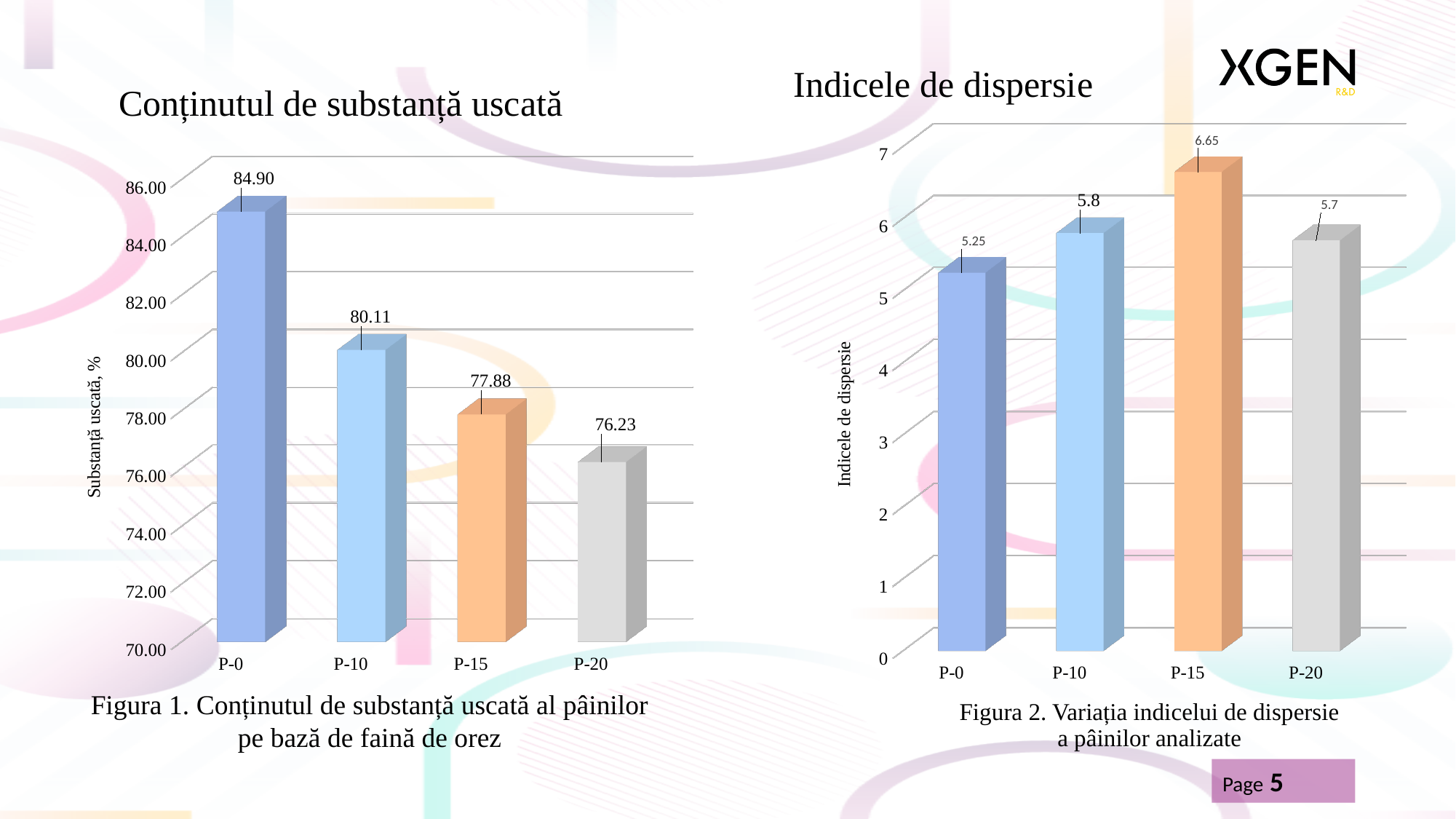
In the chart titled "Conținutul de substanță uscată", what is the value for P-15? 77.88 In the chart titled "Conținutul de substanță uscată", which category has the lowest value? P-20 What kind of chart is the chart titled "Indicele de dispersie"? bar chart In the chart titled "Indicele de dispersie", what is the value for P-15? 6.65 In the chart titled "Conținutul de substanță uscată", what is the value for P-0? 84.90 In the chart titled "Indicele de dispersie", which category has the highest value? P-15 In the chart titled "Conținutul de substanță uscată", do the values rise or fall from P-0 to P-20? fall In the chart titled "Conținutul de substanță uscată", what is the difference between the values for P-10 and P-15? 2.23 In the chart titled "Indicele de dispersie", how many categories are shown on the x axis? 4 In the chart titled "Conținutul de substanță uscată", what is the difference between the values for P-0 and P-20? 8.67 In the chart titled "Indicele de dispersie", what is the value for P-0? 5.25 In the chart titled "Indicele de dispersie", which is larger, the value for P-0 or the value for P-15? P-15